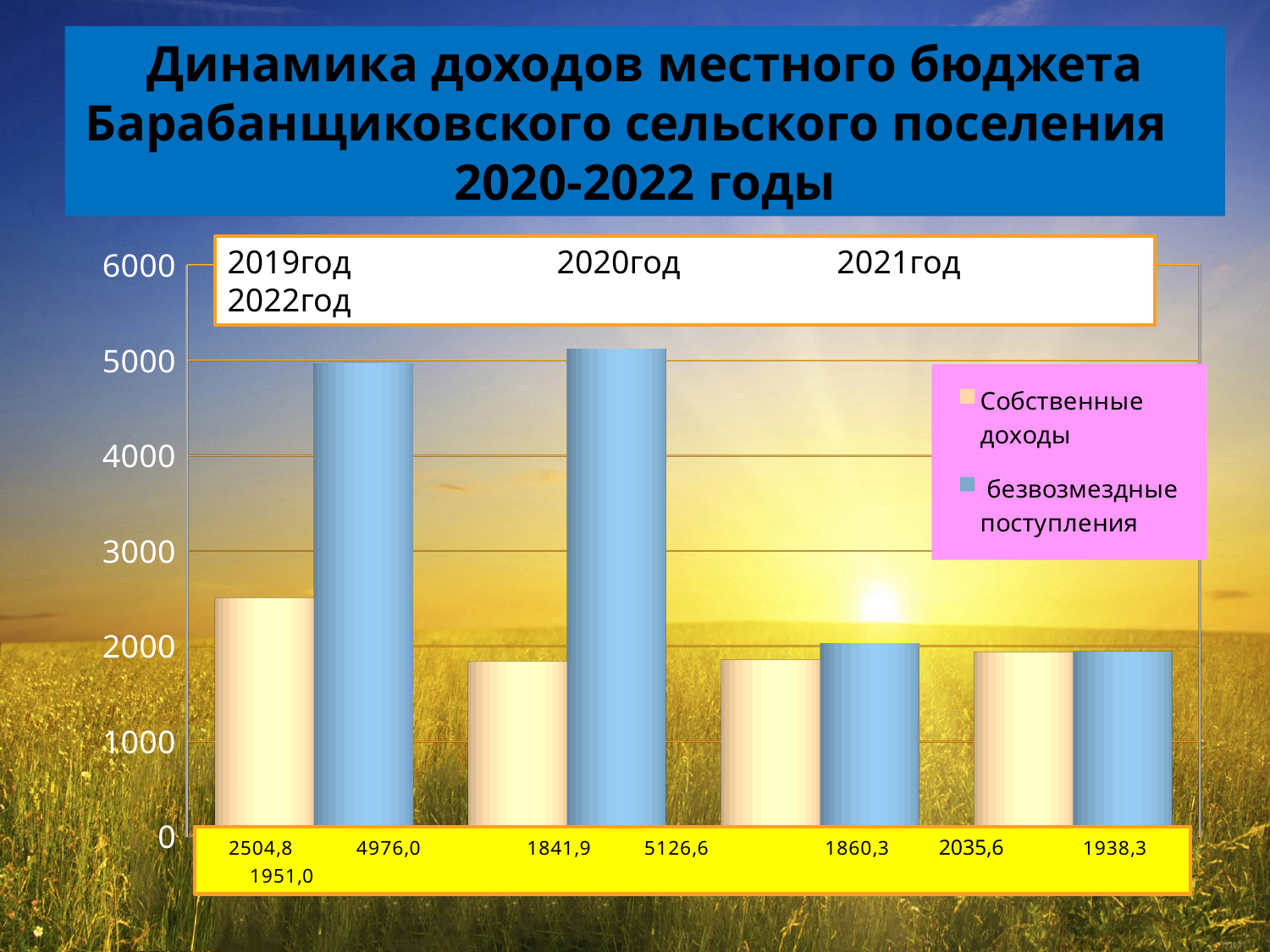
What is the value of безвозмездные поступления for 2020год? 5126,6 In which year is Собственные доходы lowest? 2020год In which year is безвозмездные поступления highest? 2020год Is the value of безвозмездные поступления for 2019год greater or less than 4000? greater What is the difference between безвозмездные поступления and Собственные доходы in 2019год? 2471,2 Which is larger in 2021год: Собственные доходы or безвозмездные поступления? безвозмездные поступления How many year categories are shown on the x axis? 4 Which colour represents безвозмездные поступления in the chart? blue What is the value of Собственные доходы for 2019год? 2504,8 How many series does the legend list? 2 What is the value of Собственные доходы for 2022год? 1938,3 What type of chart is shown on the slide? bar chart